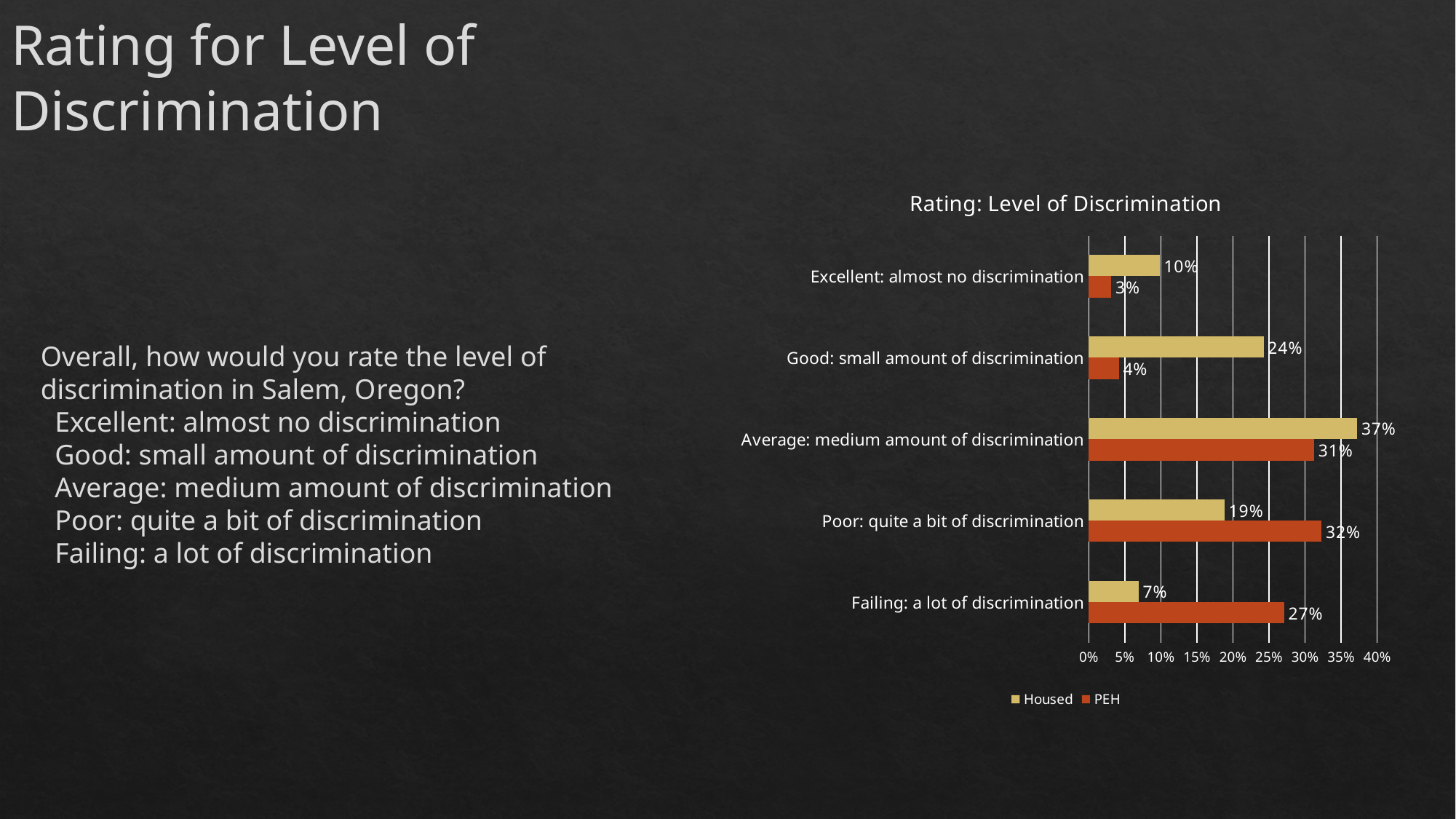
What is the difference between the PEH and Housed values for "Poor: quite a bit of discrimination"? 13% What is the PEH value for "Failing: a lot of discrimination"? 27% What is the title of the chart? Rating: Level of Discrimination Which category has the highest Housed value? Average: medium amount of discrimination How many rating categories are shown on the chart? 5 What kind of chart is shown on the slide? Bar chart What is the PEH value for "Excellent: almost no discrimination"? 3% Is the PEH value for "Poor: quite a bit of discrimination" greater or less than 30%? greater For "Good: small amount of discrimination", which series has the larger value, Housed or PEH? Housed What is the Housed value for "Average: medium amount of discrimination"? 37% Which category has the lowest PEH value? Excellent: almost no discrimination How many series does the legend list? 2